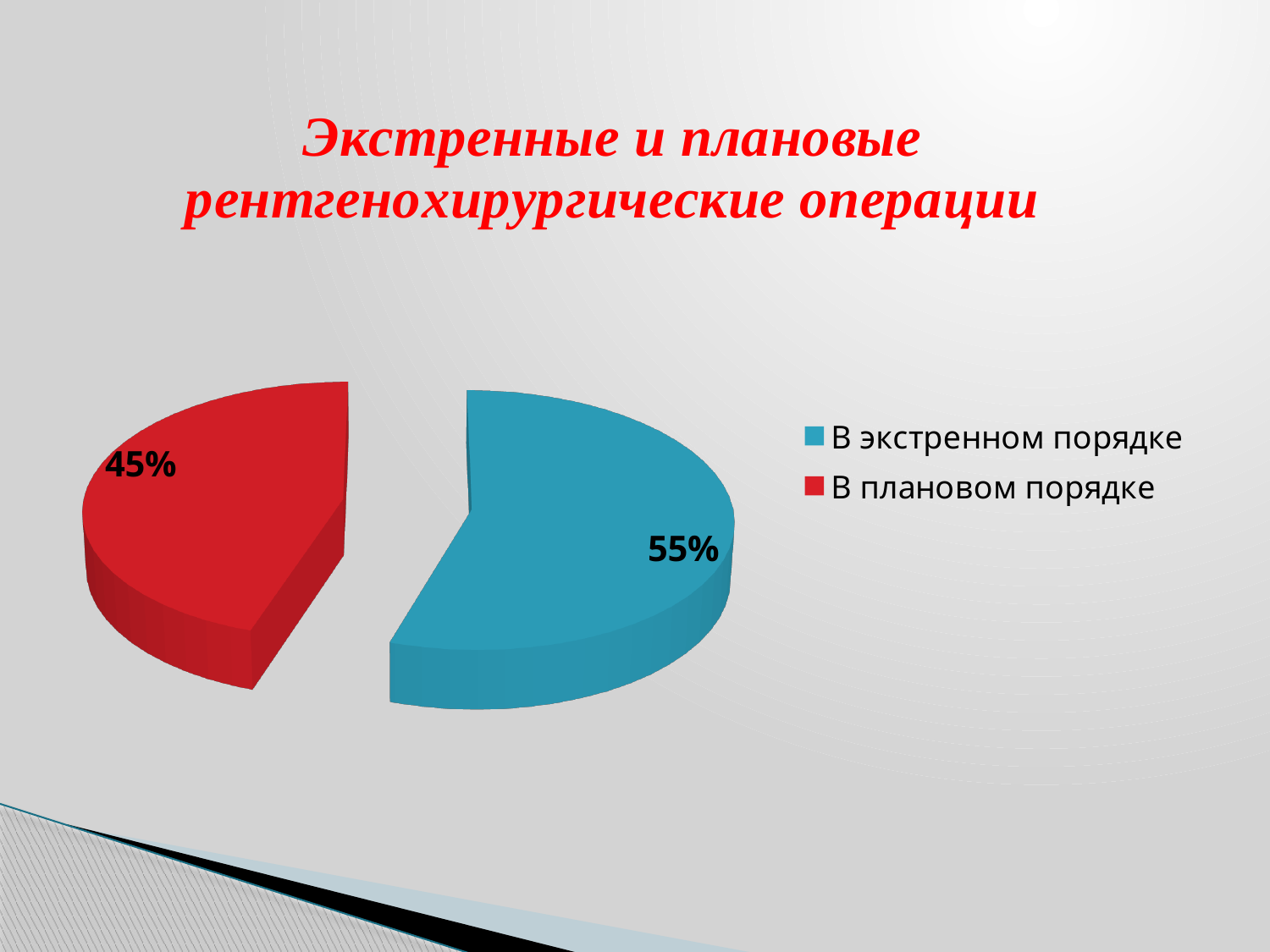
What is the value for "В экстренном порядке"? 55% How many slices does the pie chart have? 2 How many entries does the legend list? 2 Which category has the smallest share of the pie? В плановом порядке Which is larger: the share for "В экстренном порядке" or for "В плановом порядке"? В экстренном порядке What is the title of the slide? Экстренные и плановые рентгенохирургические операции What type of chart is shown on the slide? Pie chart Which category has the largest share of the pie? В экстренном порядке What is the difference between the shares of "В экстренном порядке" and "В плановом порядке"? 10% What colour is the slice for "В плановом порядке"? Red What is the value for "В плановом порядке"? 45%